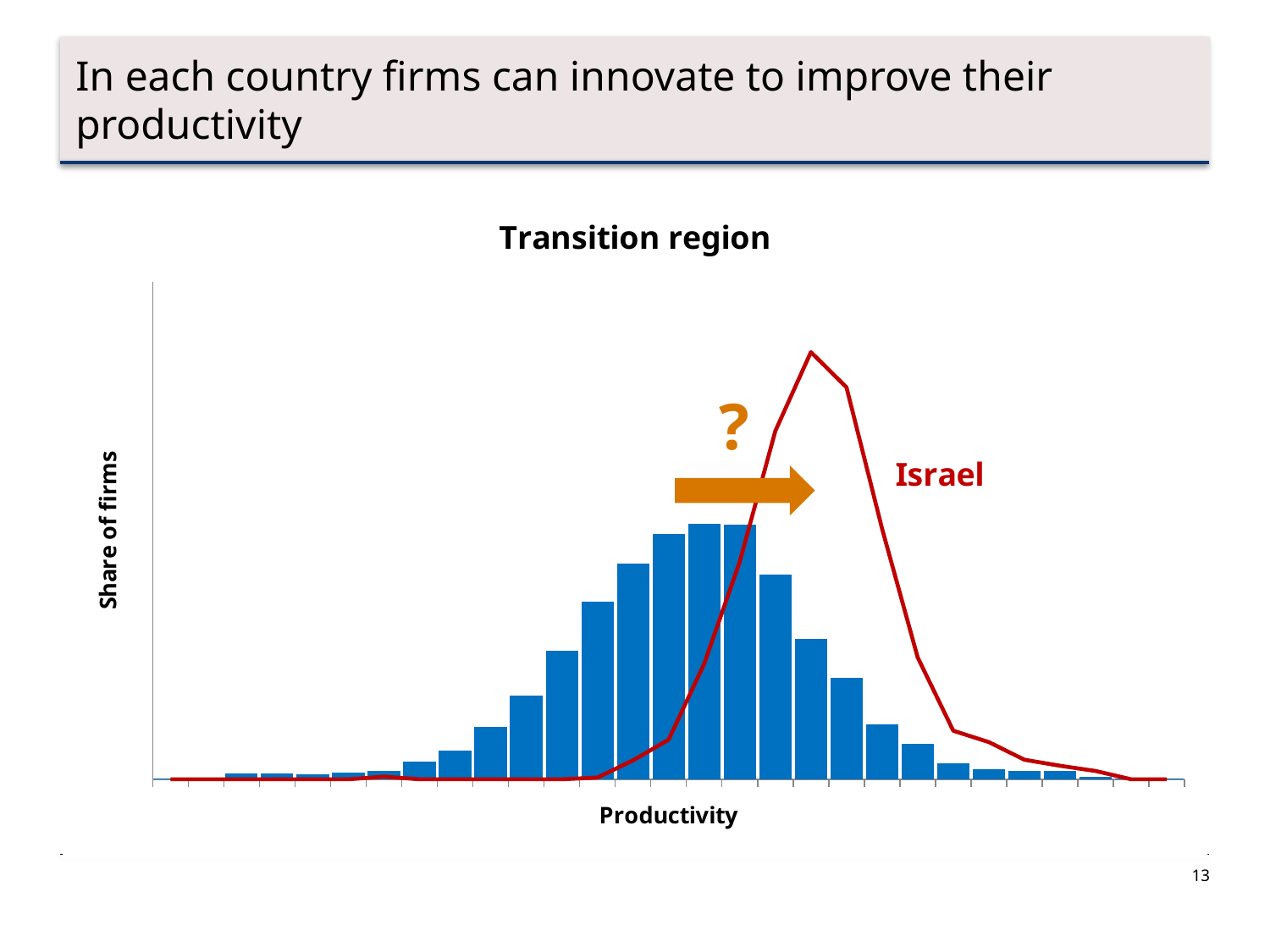
Is the peak of the Israel line to the left or to the right of the tallest blue bar? To the right How do the blue bars change moving from left to right along the Productivity axis? They rise to a peak and then fall Is the peak of the Israel line higher or lower than the tallest blue bar? Higher How many data series are plotted in the chart? 2 Which country does the red line in the chart represent? Israel What label is on the vertical axis of the chart? Share of firms What kind of chart is shown on the slide? A bar chart with a line overlaid What is the title of the chart? Transition region